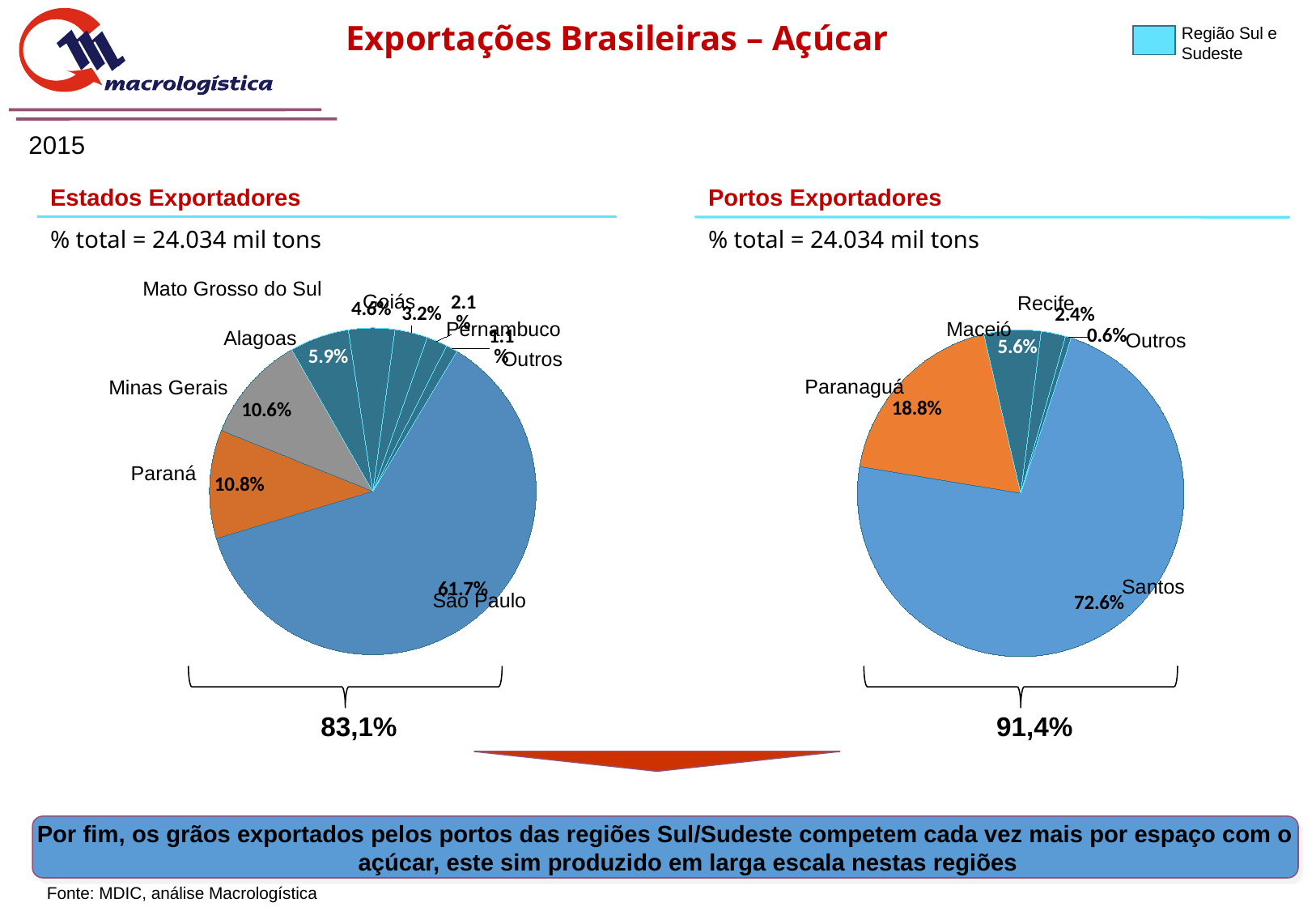
In the Estados Exportadores pie chart, what share does Minas Gerais have? 10.6% In the Estados Exportadores pie chart, which state has the largest share? São Paulo In the Portos Exportadores pie chart, what is the difference between the shares of Santos and Paranaguá? 53.8 percentage points In the Estados Exportadores pie chart, what share does São Paulo have? 61.7% In the Estados Exportadores pie chart, what share does Paraná have? 10.8% In the Portos Exportadores pie chart, what share does Santos have? 72.6% In the Estados Exportadores pie chart, what share does Alagoas have? 5.9% In the Portos Exportadores pie chart, how many slices are there? 5 What type of chart is used for Estados Exportadores? Pie chart In the Portos Exportadores pie chart, what share does Maceió have? 5.6% In the Portos Exportadores pie chart, which port has the largest share? Santos In the Portos Exportadores pie chart, what share does Paranaguá have? 18.8%